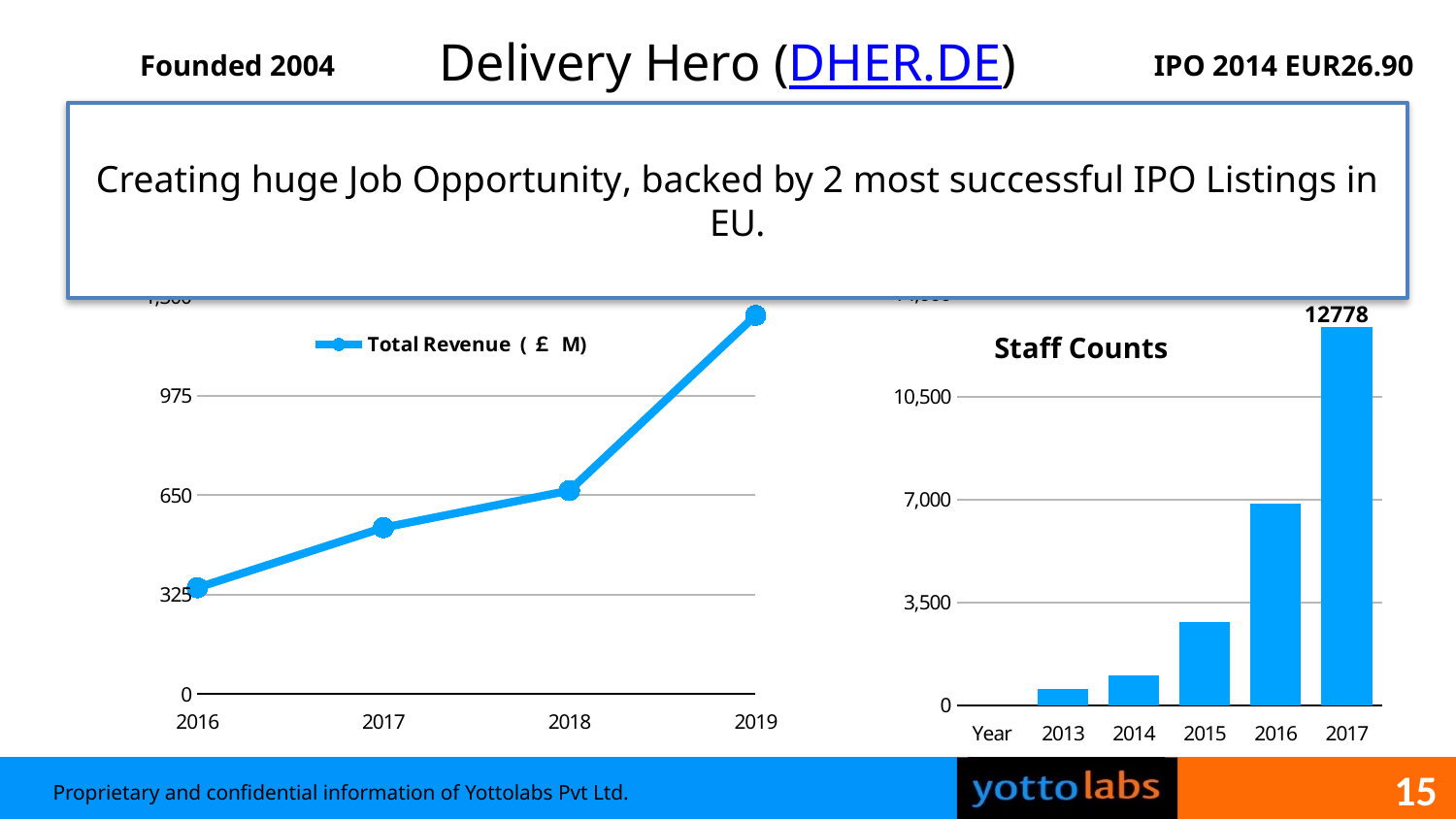
In the Total Revenue (£ M) chart, which year has the highest revenue? 2019 In the Staff Counts chart, do the values rise or fall from 2013 to 2017? rise In the Staff Counts chart, which year has the lowest staff count? 2013 In the Total Revenue (£ M) chart, how many years are plotted? 4 In the Staff Counts chart, how many years are plotted? 5 In the Staff Counts chart, what is the staff count for 2017? 12778 In the Staff Counts chart, which year has the highest staff count? 2017 What kind of chart is the Staff Counts chart? bar chart What kind of chart is the Total Revenue (£ M) chart? line chart In the Staff Counts chart, is the value for 2015 greater or less than 3,500? less In the Staff Counts chart, is the value for 2016 greater or less than 3,500? greater In the Total Revenue (£ M) chart, is the value for 2017 greater or less than 650? less